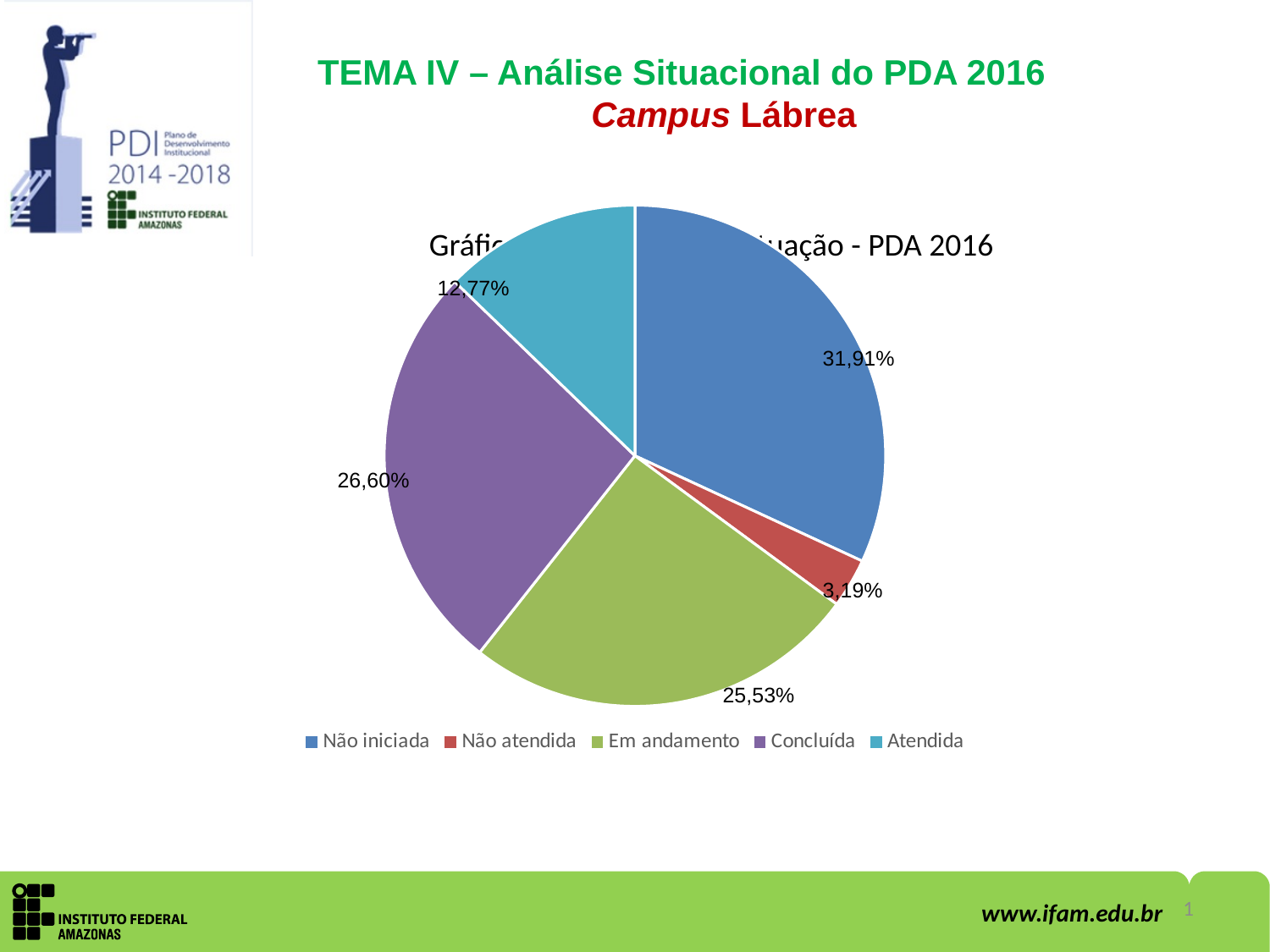
Which category has the largest slice of the pie? Não iniciada What colour is the "Atendida" slice in the pie chart? light blue (cyan) Which category has the smallest slice of the pie? Não atendida What share of the pie does the "Concluída" slice represent? 26,60% What share of the pie does the "Atendida" slice represent? 12,77% What kind of chart is shown on the slide? pie chart What share of the pie does the "Em andamento" slice represent? 25,53% Which is larger, the "Concluída" slice or the "Em andamento" slice? Concluída How many categories does the pie chart show? 5 What is the difference in percentage points between the "Não iniciada" and "Atendida" slices? 19,14